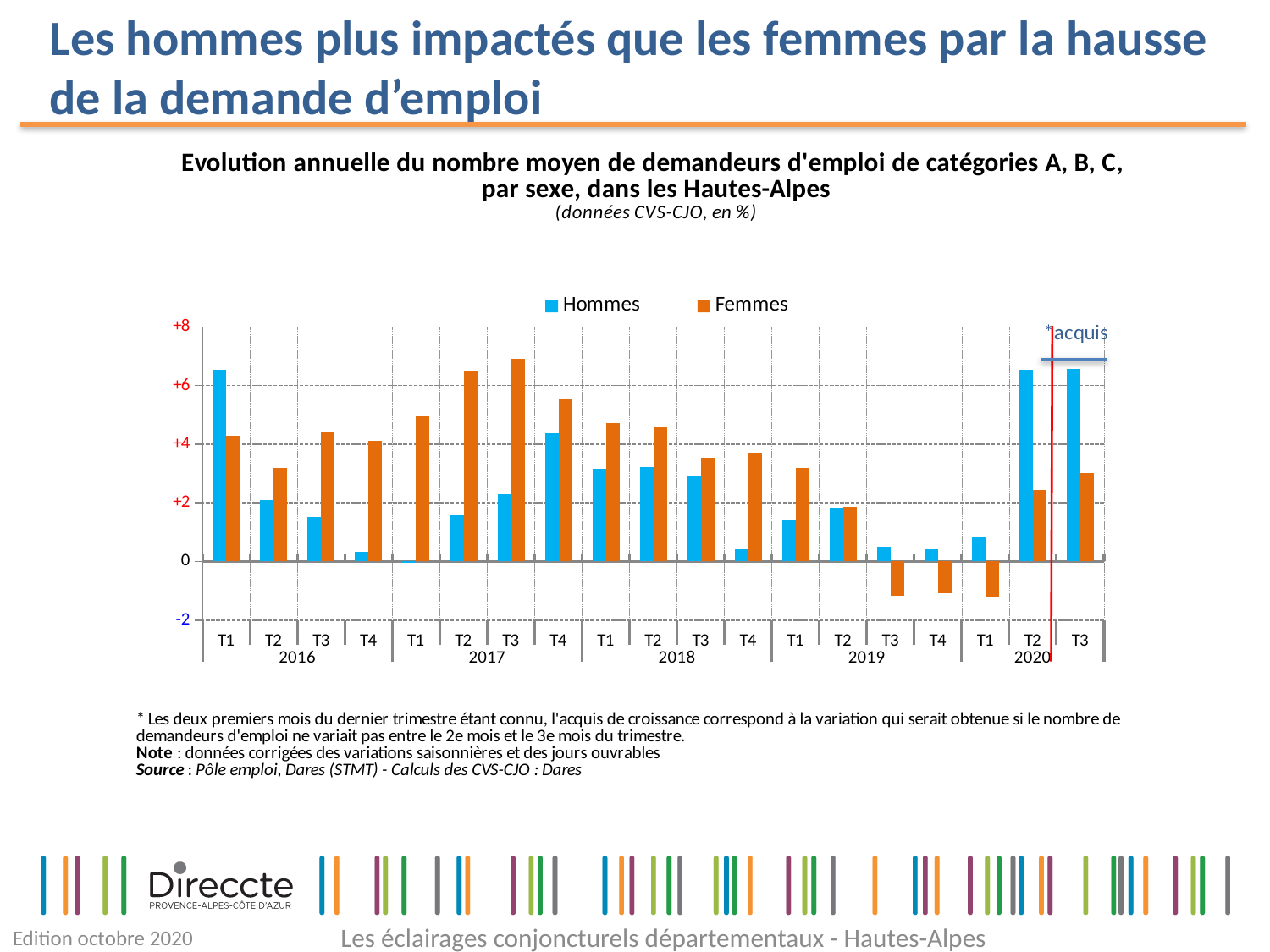
Which colour represents the Hommes series in the legend? blue Is the value for Hommes in T4 2016 greater or less than +2? less Is the value for Femmes in T3 2019 greater or less than 0? less Is the value for Femmes in T3 2017 greater or less than +6? greater What kind of chart is shown on the slide? bar chart How many quarters (categories) are plotted along the x axis? 19 In T2 2017, which series has the larger value, Hommes or Femmes? Femmes In T2 2020, which series has the larger value, Hommes or Femmes? Hommes In which quarter is the value for Femmes the highest? T3 2017 How many series does the legend list? 2 Do the values for Femmes rise or fall from T3 2017 to T1 2020? fall